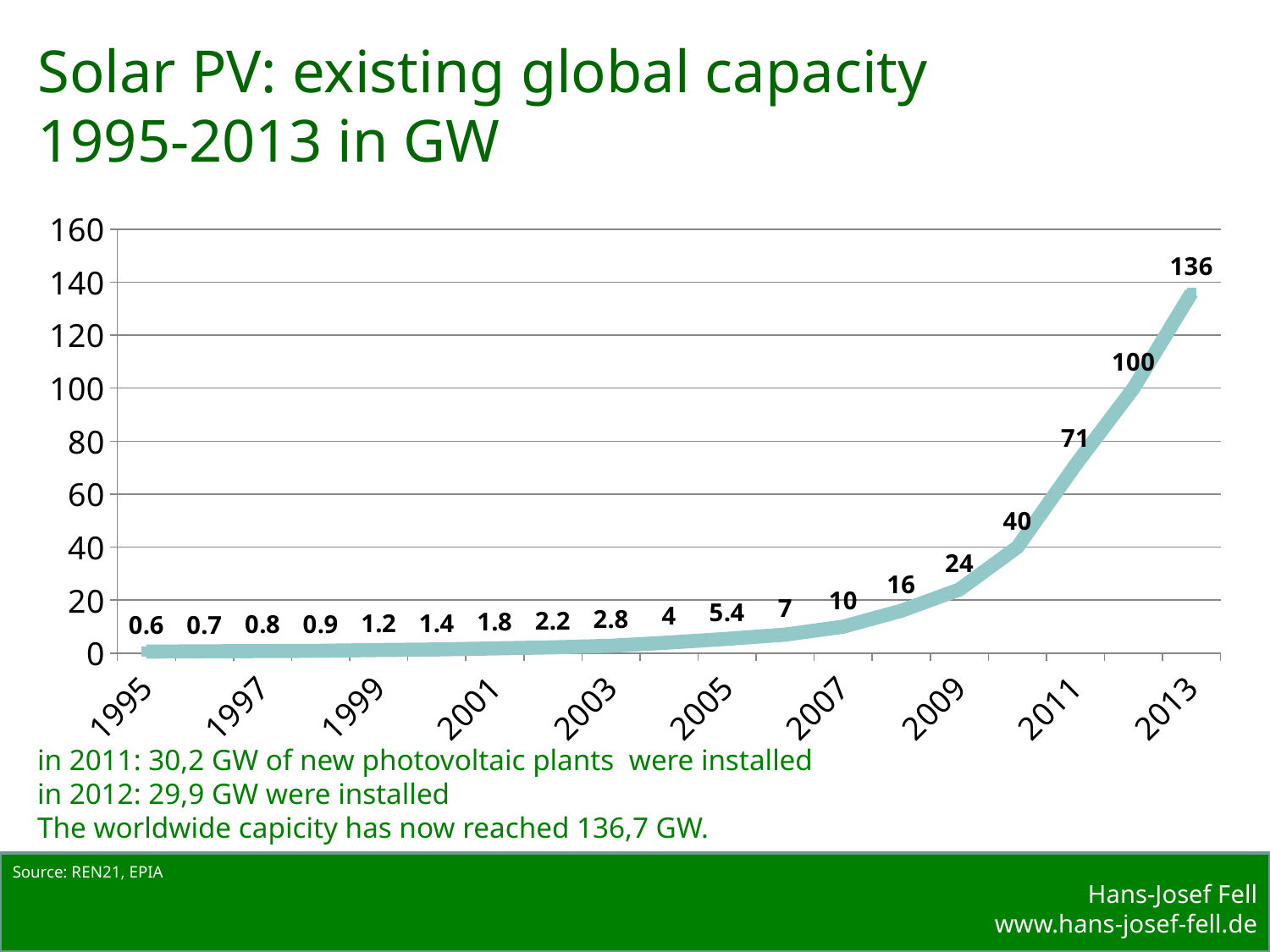
How many data points are plotted on the chart? 19 What is the value for 2013? 136 What kind of chart is shown? line chart Which year has the lowest value? 1995 What is the difference between the values for 2013 and 2011? 65 Which year has the highest value? 2013 Which is larger, the value for 2009 or the value for 2007? 2009 What is the value for 1995? 0.6 What is the value for 2009? 24 What is the value for 2007? 10 What is the value for 2011? 71 Do the values rise or fall from 1995 to 2013? rise